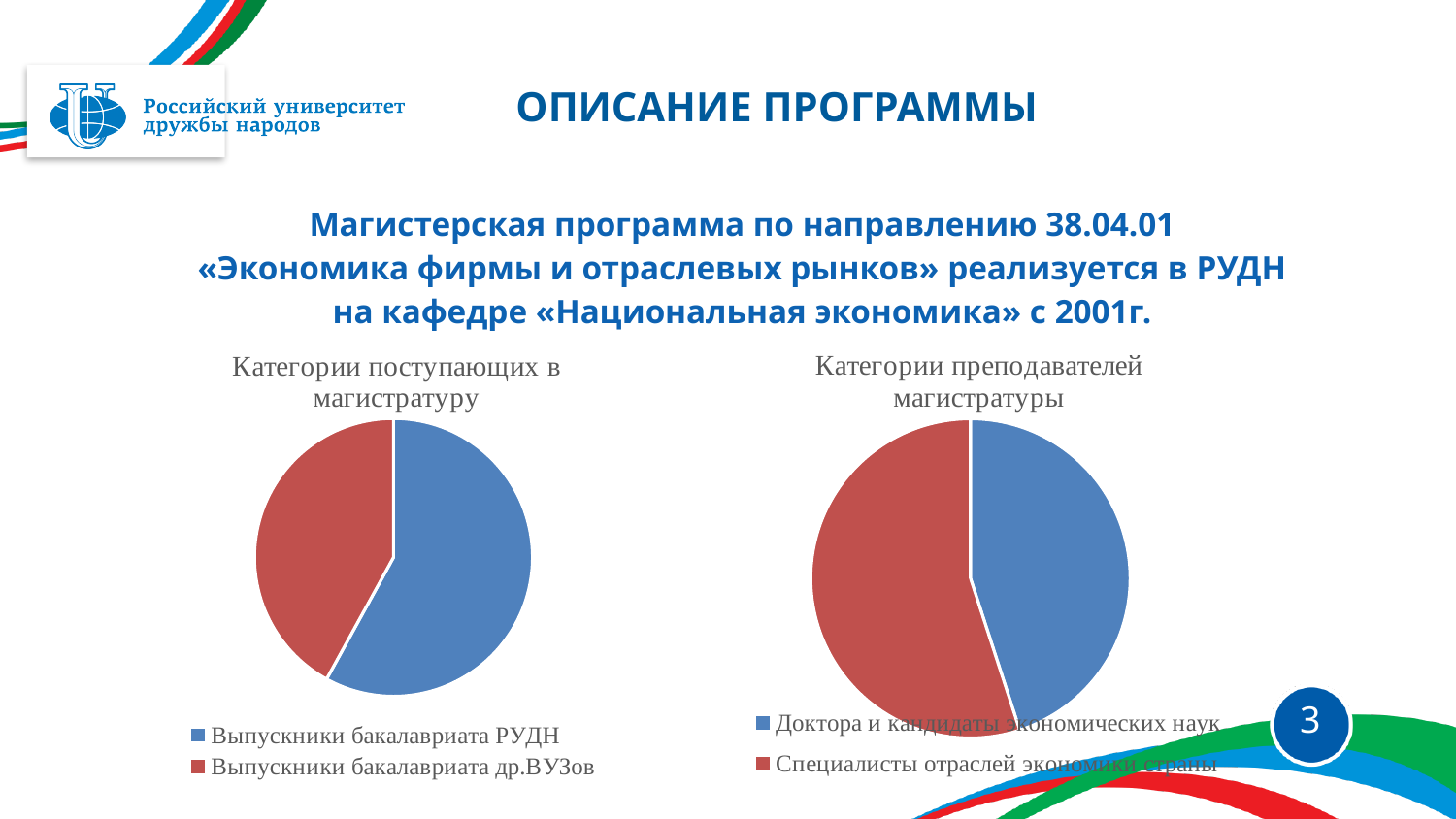
What is the title of the pie chart on the left side of the slide? Категории поступающих в магистратуру What kind of chart is the right chart titled «Категории преподавателей магистратуры»? Pie chart How many slices does the left pie chart «Категории поступающих в магистратуру» have? 2 How many slices does the right pie chart «Категории преподавателей магистратуры» have? 2 In the left chart «Категории поступающих в магистратуру», which slice is larger: Выпускники бакалавриата РУДН or Выпускники бакалавриата др.ВУЗов? Выпускники бакалавриата РУДН In the left chart «Категории поступающих в магистратуру», which category has the largest slice? Выпускники бакалавриата РУДН How many entries does the legend of the right chart «Категории преподавателей магистратуры» list? 2 In the left chart «Категории поступающих в магистратуру», which category has the smallest slice? Выпускники бакалавриата др.ВУЗов In the left chart «Категории поступающих в магистратуру», what colour is the slice for Выпускники бакалавриата др.ВУЗов? Red What kind of chart is the left chart titled «Категории поступающих в магистратуру»? Pie chart In the right chart «Категории преподавателей магистратуры», which slice is larger: Доктора и кандидаты экономических наук or Специалисты отраслей экономики страны? Специалисты отраслей экономики страны